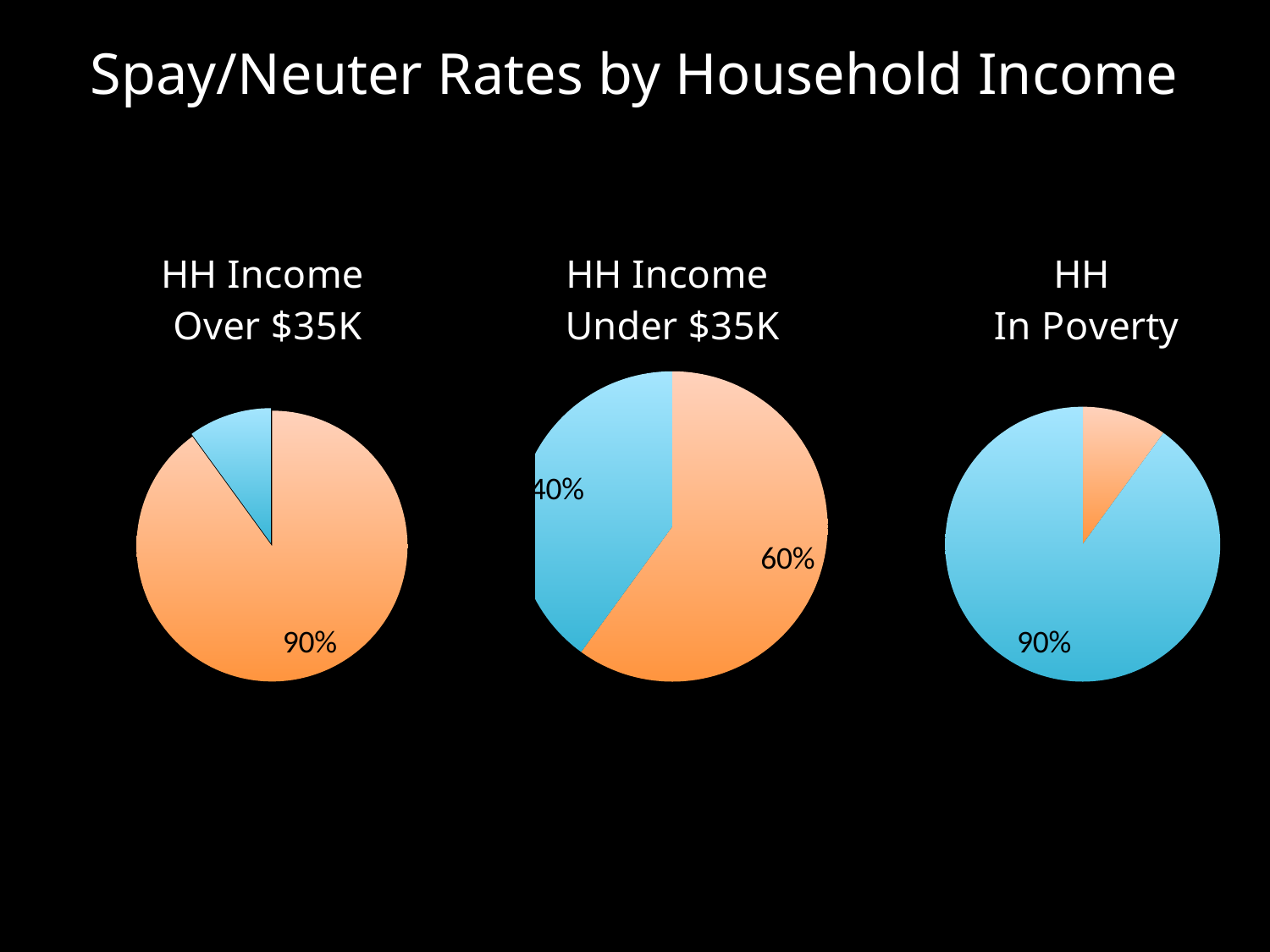
In the 'HH Income Under $35K' pie chart, what is the difference between the orange and blue slice shares? 20% In the 'HH In Poverty' pie chart, which slice is larger, the orange or the blue? Blue In the 'HH Income Over $35K' pie chart, what share is labelled on the orange slice? 90% In the 'HH Income Under $35K' pie chart, what share is labelled on the orange slice? 60% Which pie chart has the smallest blue slice? HH Income Over $35K In the 'HH Income Under $35K' pie chart, which slice is larger, the orange or the blue? Orange Which pie chart has the largest blue slice? HH In Poverty How many pie charts are on the slide? 3 What is the title of the slide? Spay/Neuter Rates by Household Income In the 'HH Income Under $35K' pie chart, what share is labelled on the blue slice? 40% What kind of charts are shown on the slide? Pie charts